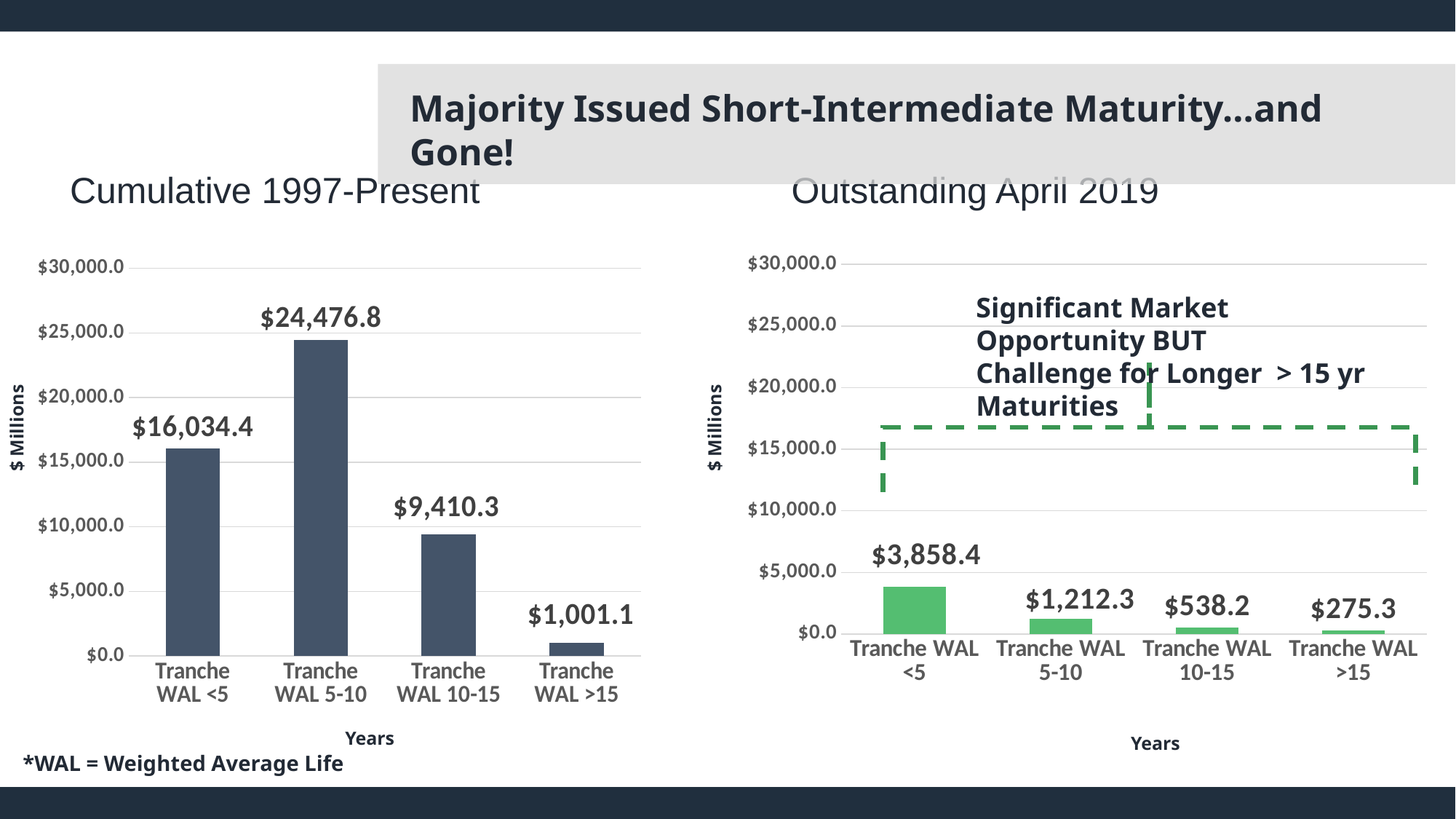
In the 'Outstanding April 2019' chart, which category has the lowest value? Tranche WAL >15 In the 'Cumulative 1997-Present' chart, which is larger: the value for Tranche WAL <5 or Tranche WAL 10-15? Tranche WAL <5 What kind of chart is the 'Cumulative 1997-Present' chart? bar chart In the 'Outstanding April 2019' chart, what is the value for Tranche WAL 10-15? $538.2 In the 'Cumulative 1997-Present' chart, is the value for Tranche WAL 10-15 greater or less than $10,000.0? less How many categories are shown in the 'Outstanding April 2019' chart? 4 In the 'Cumulative 1997-Present' chart, what is the value for Tranche WAL >15? $1,001.1 In the 'Outstanding April 2019' chart, what is the difference between the values for Tranche WAL 5-10 and Tranche WAL 10-15? $674.1 In the 'Cumulative 1997-Present' chart, what is the value for Tranche WAL 5-10? $24,476.8 In the 'Cumulative 1997-Present' chart, which category has the highest value? Tranche WAL 5-10 In the 'Outstanding April 2019' chart, what is the value for Tranche WAL <5? $3,858.4 In the 'Cumulative 1997-Present' chart, what is the difference between the values for Tranche WAL 5-10 and Tranche WAL <5? $8,442.4